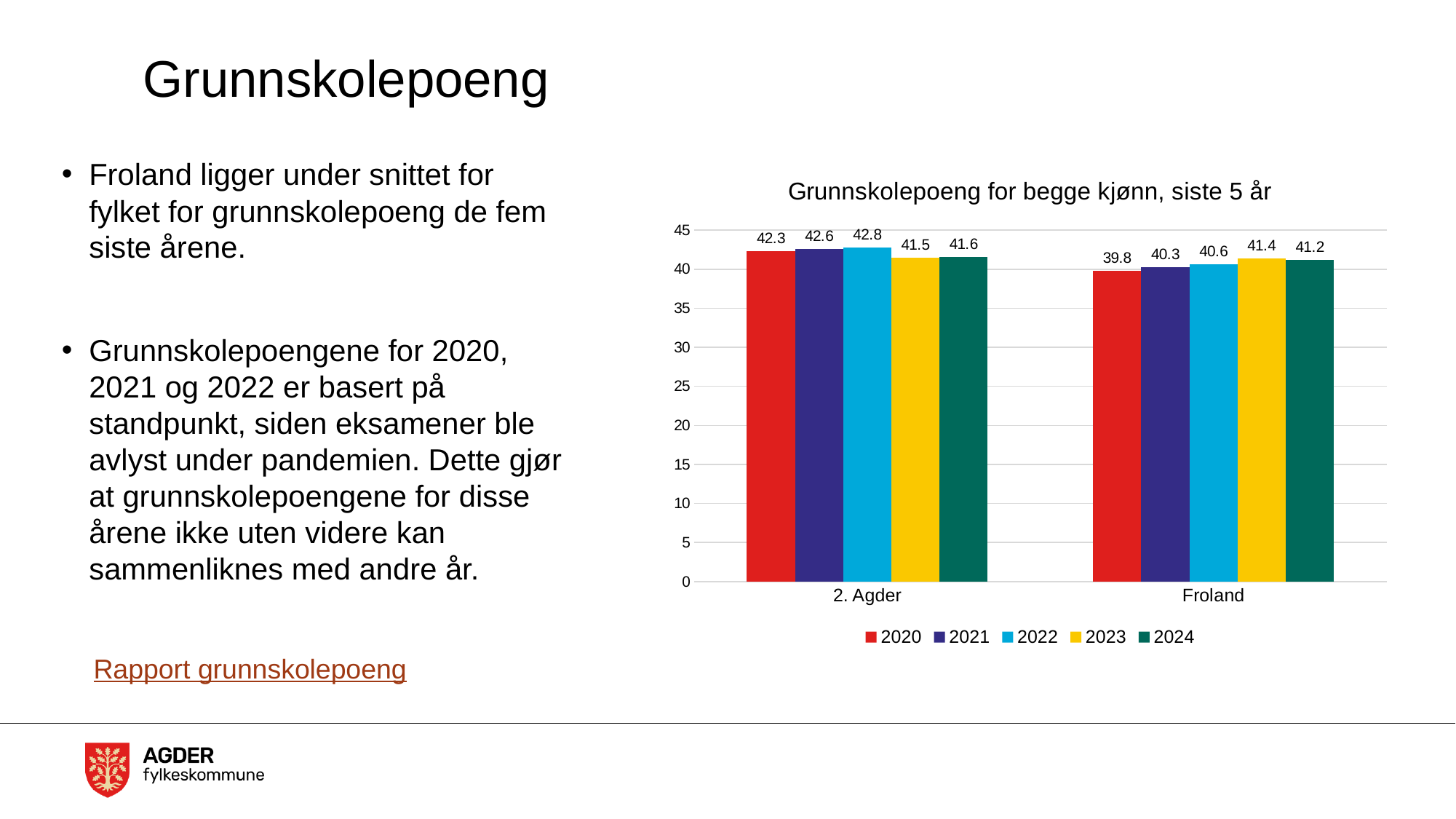
Which year has the highest value for 2. Agder? 2022 Which is larger, the 2023 value for 2. Agder or the 2023 value for Froland? 2. Agder What is the title of the chart? Grunnskolepoeng for begge kjønn, siste 5 år How many series does the legend list? 5 Which year has the lowest value for Froland? 2020 What is the value for Froland in 2020? 39.8 What is the value for 2. Agder in 2023? 41.5 What kind of chart is shown on the slide? Bar chart How many categories are shown on the x axis? 2 What is the value for Froland in 2024? 41.2 What is the value for 2. Agder in 2022? 42.8 What is the difference between the 2. Agder and Froland values in 2020? 2.5